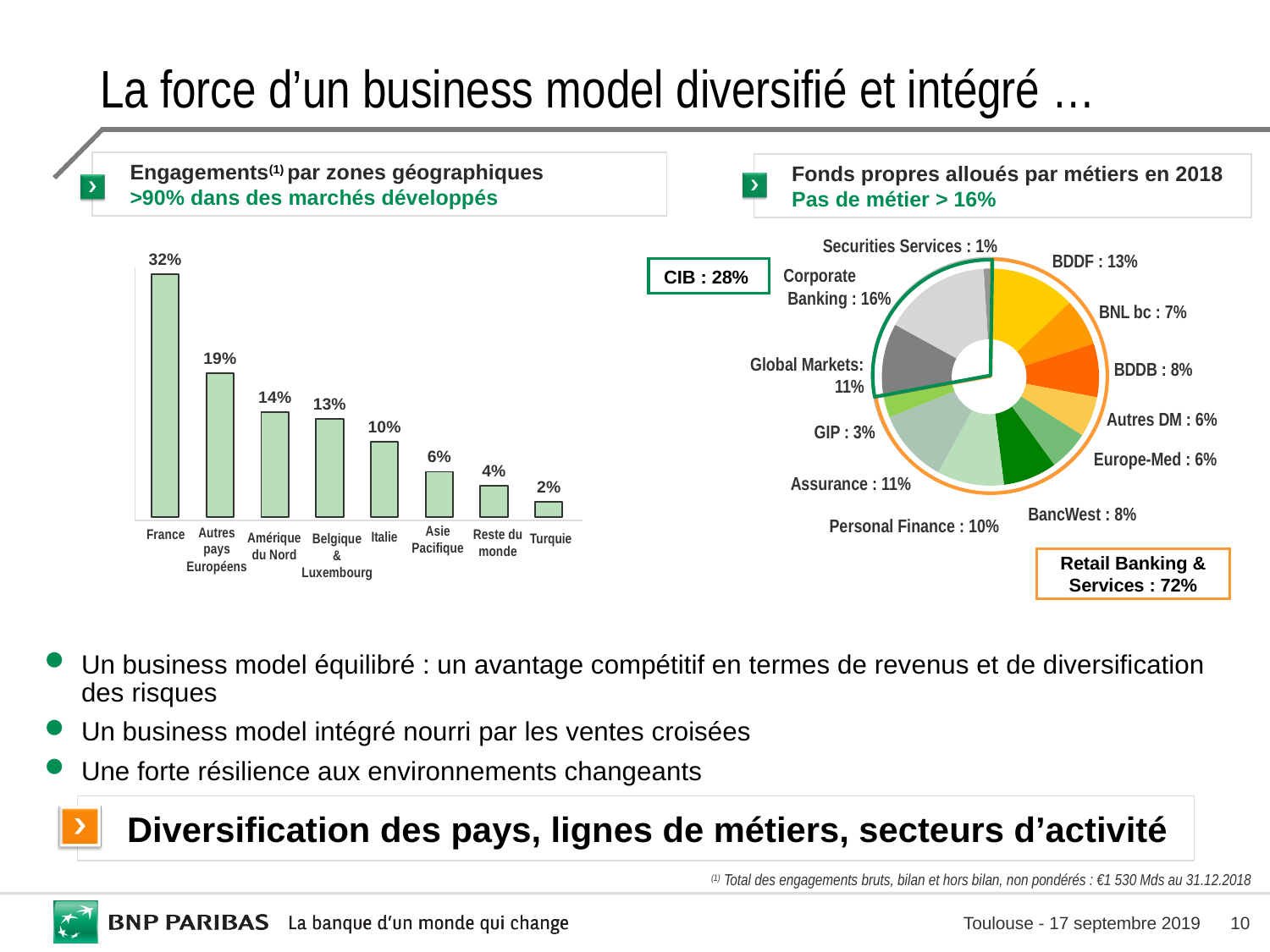
In the pie chart 'Fonds propres alloués par métiers en 2018', what share does Corporate Banking have? 16% In the pie chart 'Fonds propres alloués par métiers en 2018', which business line has the smallest share? Securities Services In the bar chart 'Engagements par zones géographiques', do the values rise or fall from left to right? Fall In the bar chart 'Engagements par zones géographiques', what is the value for Amérique du Nord? 14% What kind of chart is 'Engagements par zones géographiques'? Bar chart In the bar chart 'Engagements par zones géographiques', what is the value for France? 32% In the bar chart 'Engagements par zones géographiques', which category has the lowest value? Turquie In the pie chart 'Fonds propres alloués par métiers en 2018', what share is attributed to Retail Banking & Services? 72% In the pie chart 'Fonds propres alloués par métiers en 2018', what is the difference between BDDF and BNL bc? 6% In the bar chart 'Engagements par zones géographiques', what is the difference between France and Autres pays Européens? 13% In the bar chart 'Engagements par zones géographiques', which is larger: Italie or Asie Pacifique? Italie How many categories are shown in the bar chart 'Engagements par zones géographiques'? 8